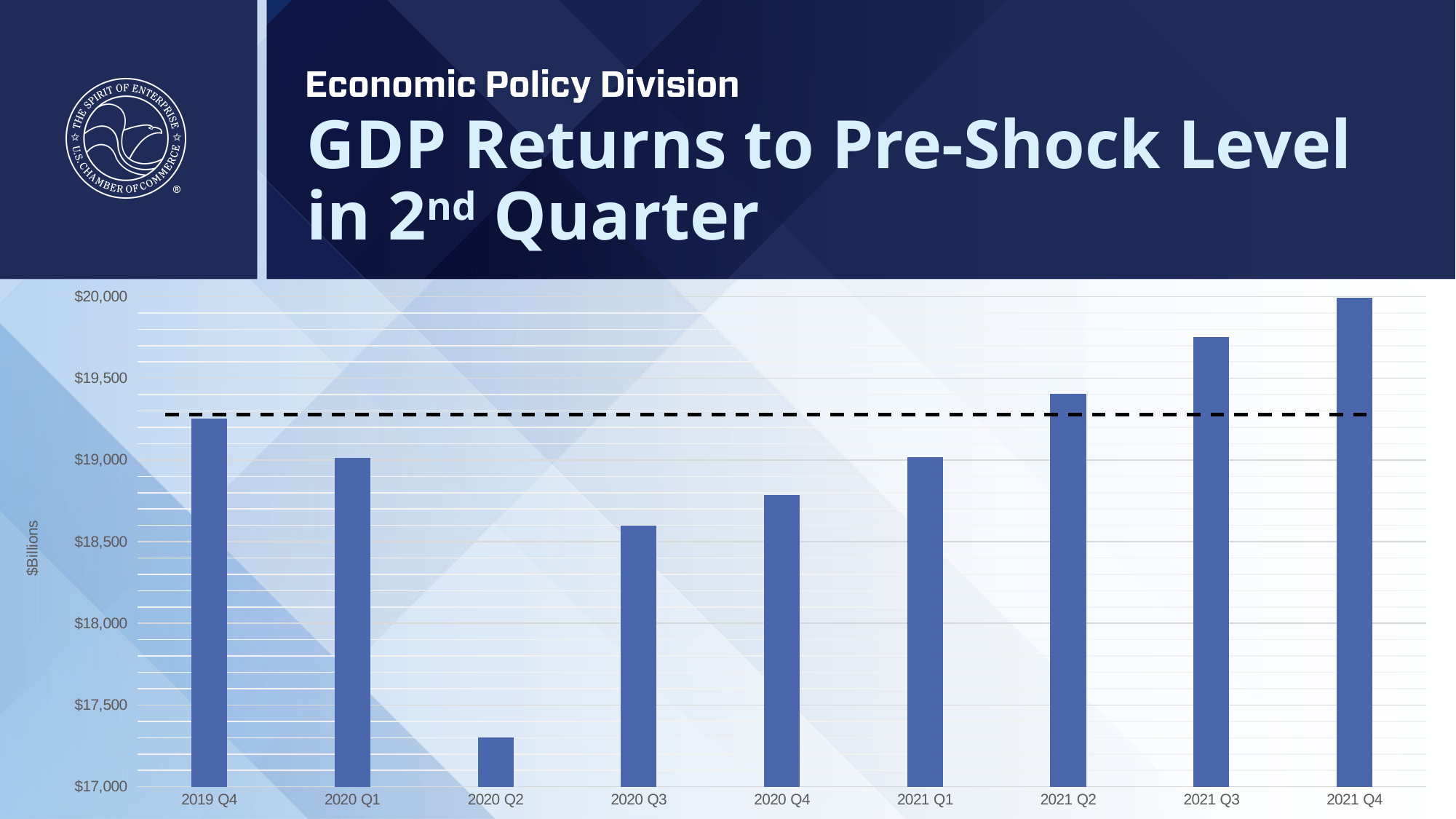
What kind of chart is shown on the slide? bar chart What is the label on the vertical axis of the chart? $Billions Which quarter has the lowest GDP value on the chart? 2020 Q2 Is the value for 2020 Q2 greater or less than $17,500? less Is the value for 2021 Q3 greater or less than $19,500? greater Is the value for 2021 Q2 greater or less than $19,500? less Which quarter has the highest GDP value on the chart? 2021 Q4 Do the values rise or fall from 2020 Q2 to 2021 Q4? rise Which is larger, the value for 2019 Q4 or the value for 2020 Q1? 2019 Q4 How many quarters are plotted on the chart? 9